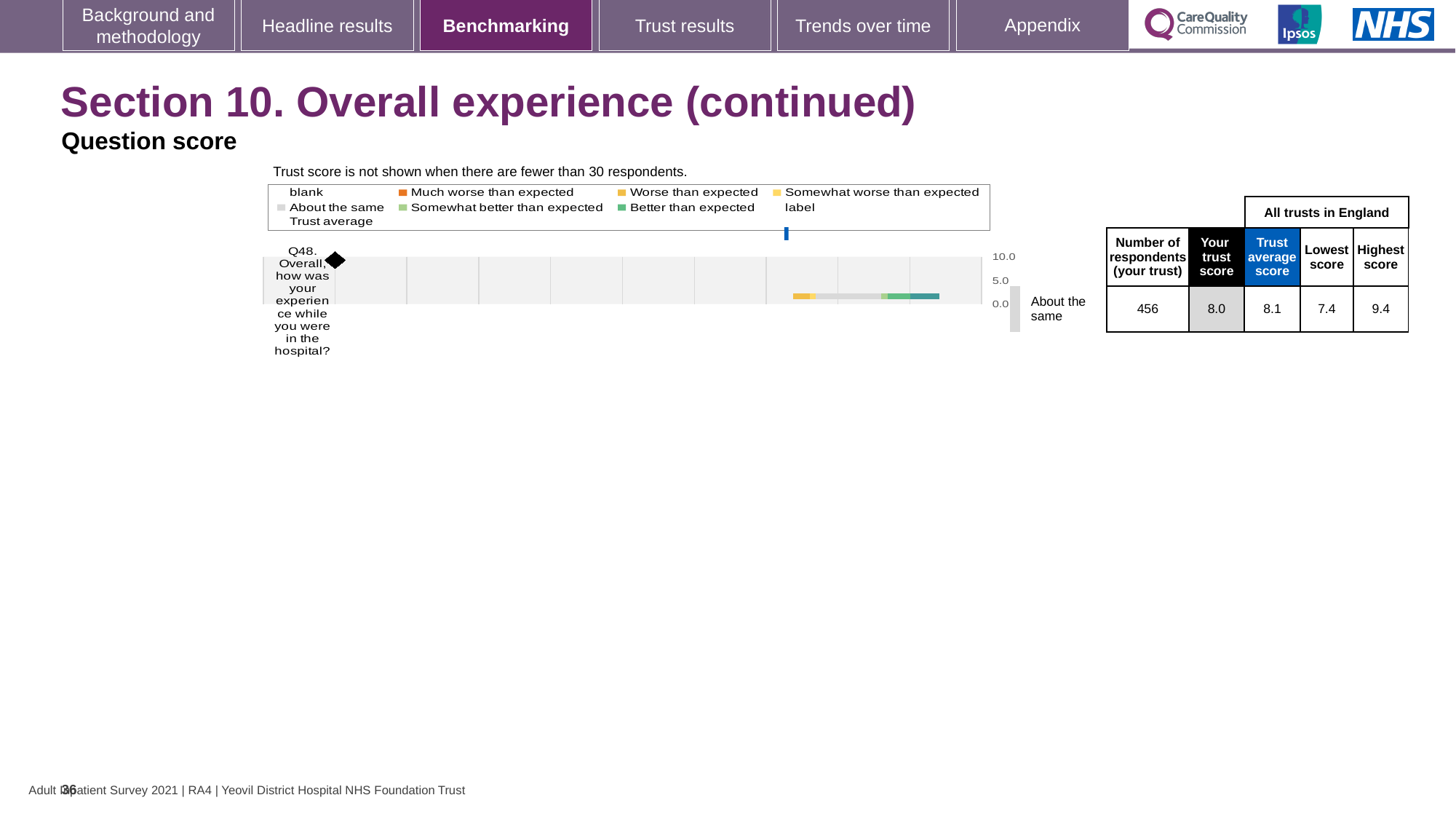
How many respondents from the trust answered Q48? 456 What is the highest value shown on the chart's score axis? 10.0 How many survey questions are plotted in the chart? 1 What is the trust average score for Q48 across all trusts in England? 8.1 What is the highest score for Q48 among all trusts in England? 9.4 What is the difference between the highest score and the lowest score for Q48 among all trusts in England? 2.0 What is the trust score for Q48 shown in the table? 8.0 What is the lowest score for Q48 among all trusts in England? 7.4 Which is larger for Q48: the trust's own score or the trust average score for all trusts in England? Trust average score Which question number is plotted in the chart? Q48 What kind of chart is shown on the slide? bar chart What benchmark rating is shown next to the chart for Q48? About the same